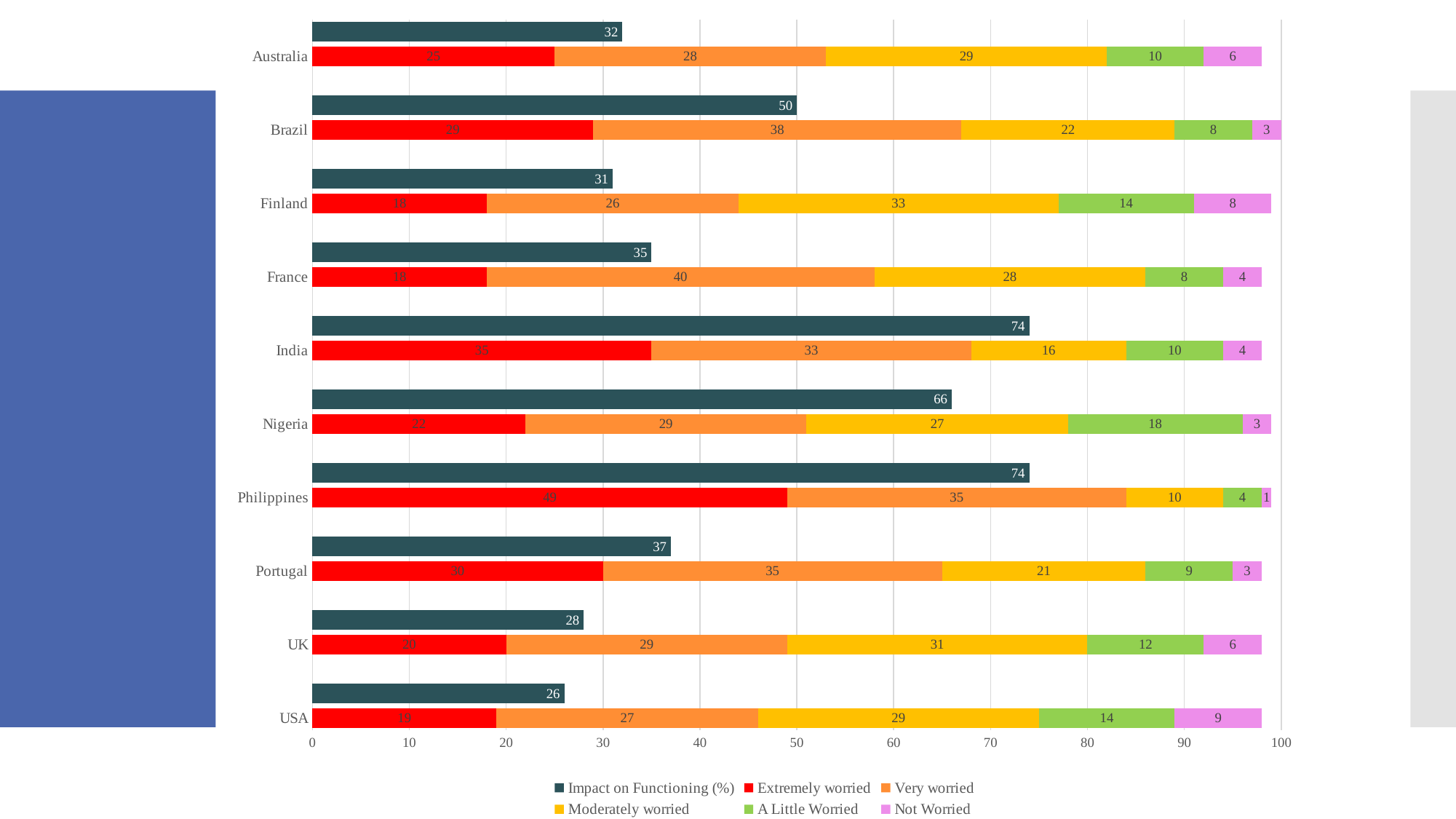
Which is larger, the Moderately worried value for Finland or for Nigeria? Finland Which country has the lowest Impact on Functioning (%) value? USA How many series does the legend list? 6 Which country has the highest Not Worried value? USA What is the difference between the Impact on Functioning (%) values for India and Australia? 42 What is the Extremely worried value for the Philippines? 49 What type of chart is shown on the slide? Stacked bar chart What is the total of the stacked worry bar (Extremely worried through Not Worried) for Brazil? 100 What is the Impact on Functioning (%) value for Brazil? 50 How many countries are listed on the vertical axis of the chart? 10 Which country has the highest Extremely worried value? Philippines What is the Very worried value for France? 40